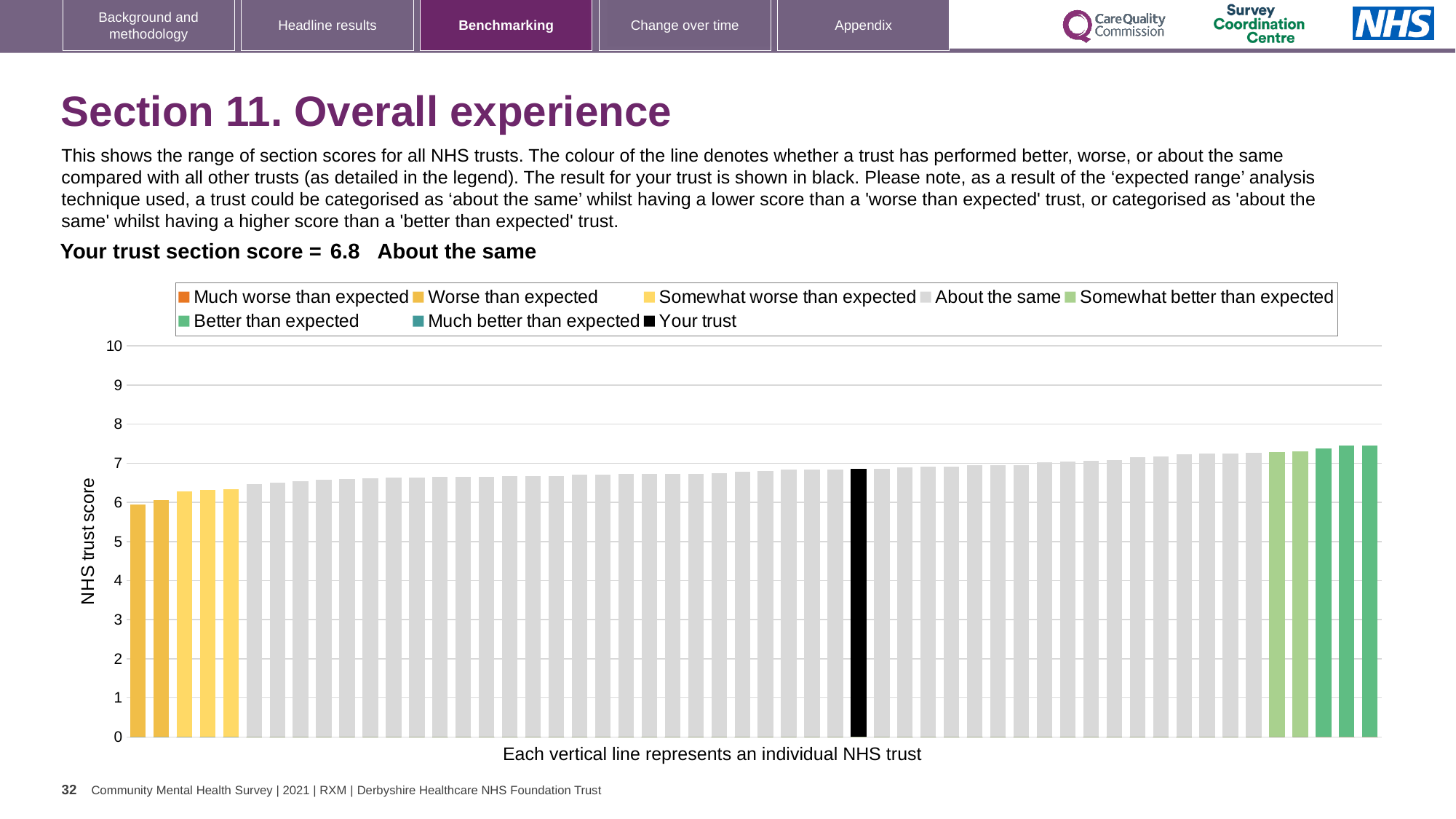
Is the value of the shortest bar in the chart greater or less than 7? less How many entries does the chart legend list? 8 Which performance category is your trust placed in? About the same Is the value for your trust greater or less than 7? less What is the section score for your trust shown on the slide? 6.8 Do the bar values rise or fall from left to right along the x axis? rise What kind of chart is shown on the slide? bar chart What is the label on the vertical axis of the chart? NHS trust score Is the value for your trust greater or less than 5? greater What colour is the bar representing your trust? black